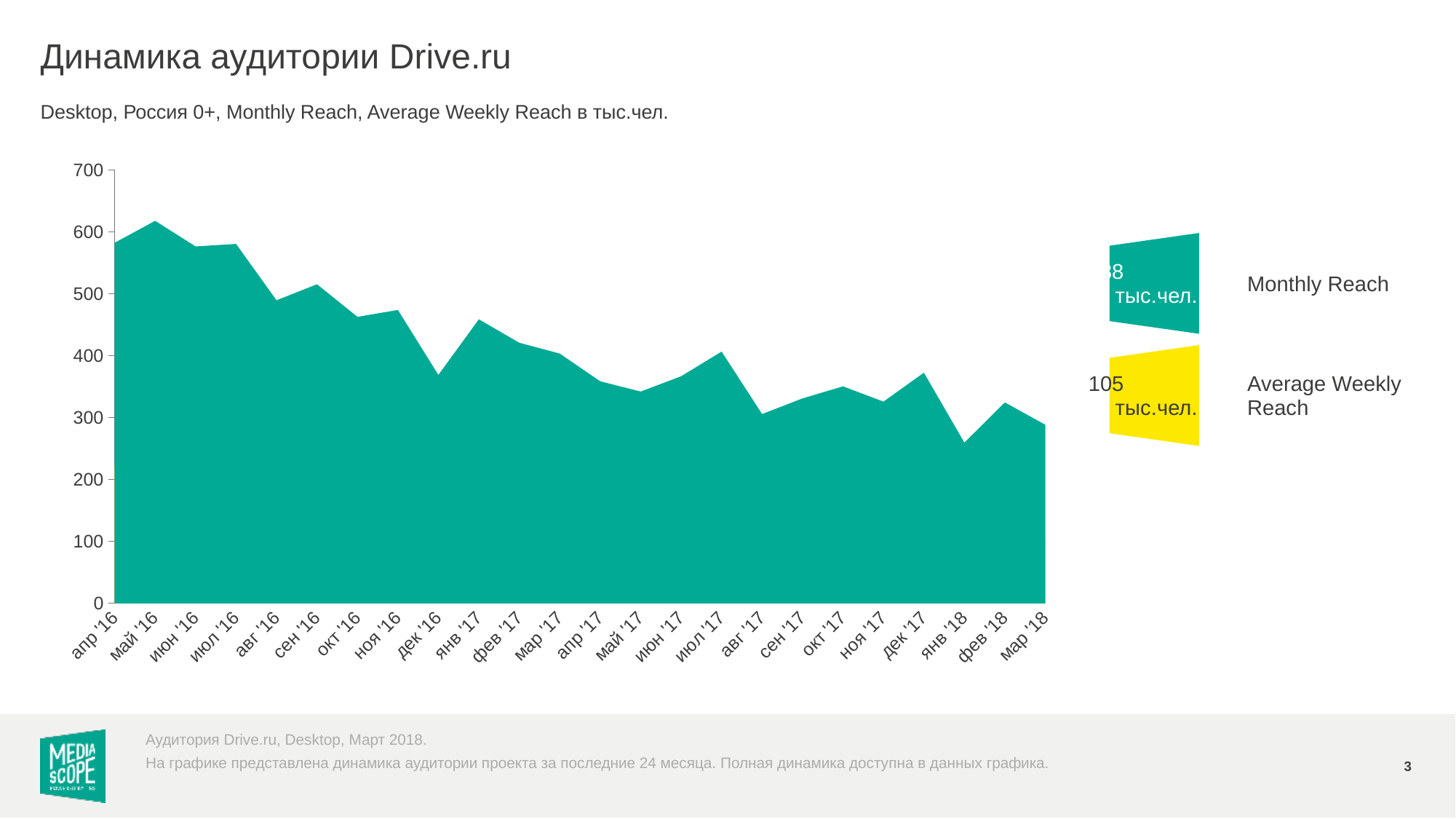
Overall, does the Monthly Reach rise or fall from апр '16 to мар '18? Fall Is the Monthly Reach value for янв '18 greater or less than 300? less What is the title of the slide? Динамика аудитории Drive.ru Which month has the highest Monthly Reach value on the chart? май '16 Which month has a larger Monthly Reach value, май '16 or мар '18? май '16 What kind of chart is shown on the slide? Area chart Which month has the lowest Monthly Reach value on the chart? янв '18 What Average Weekly Reach value is shown in the yellow box on the slide? 105 тыс.чел. Is the Monthly Reach value for апр '16 greater or less than 500? greater Is the Monthly Reach value for авг '17 greater or less than 400? less How many months are plotted along the x axis of the chart? 24